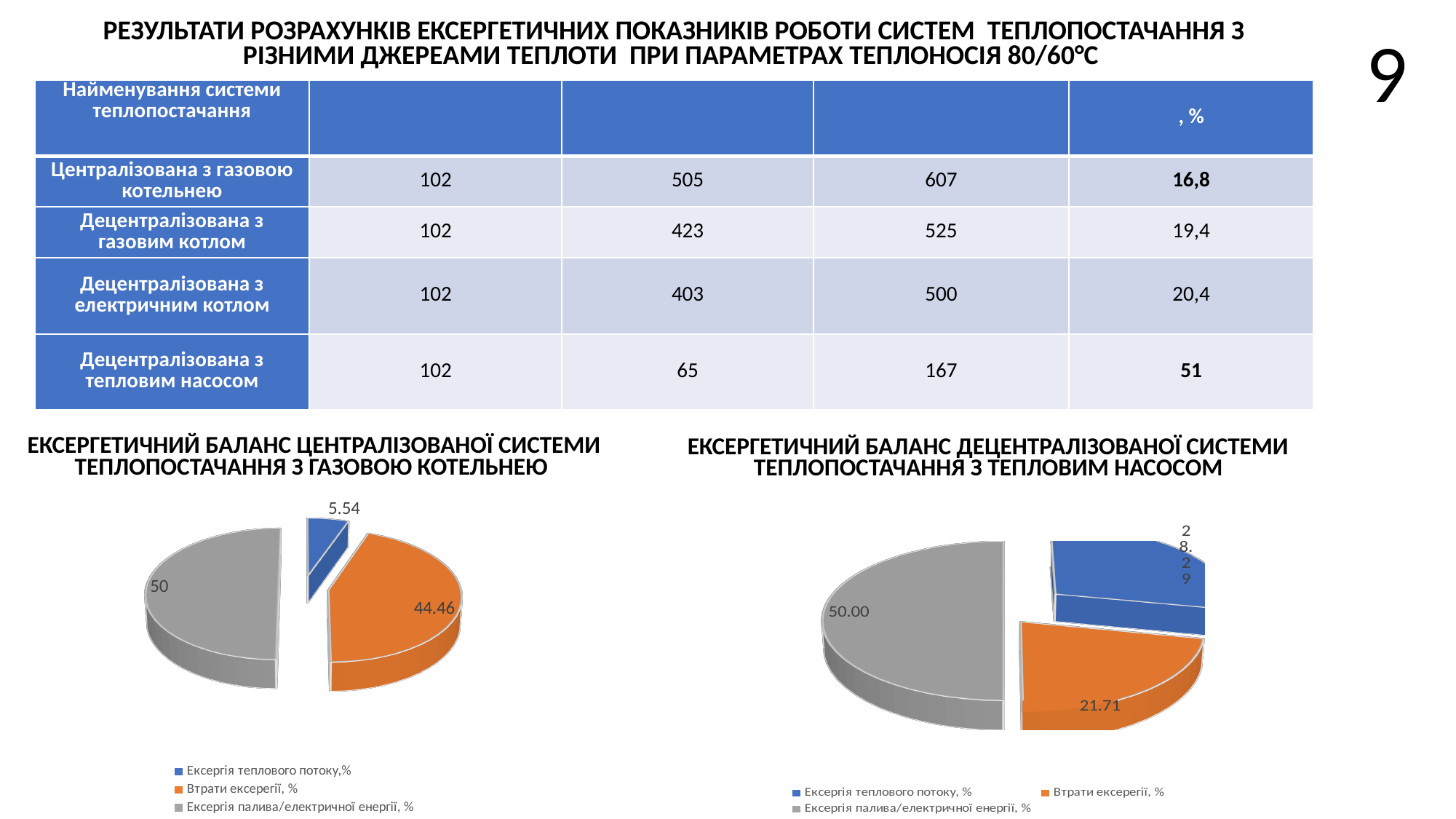
In the right pie chart (decentralised system with heat pump), what colour is the slice for Втрати ексерегії, %? Orange In the right pie chart (decentralised system with heat pump), what is the value for Ексергія палива/електричної енергії, %? 50.00 In the left pie chart (centralised system with gas boiler house), what is the value for Втрати ексерегії, %? 44.46 In the left pie chart (centralised system with gas boiler house), what is the difference between the values for Ексергія палива/електричної енергії and Втрати ексерегії? 5.54 In the right pie chart (decentralised system with heat pump), which is larger: Ексергія теплового потоку or Втрати ексерегії? Ексергія теплового потоку, % How many slices does the left pie chart (centralised system with gas boiler house) have? 3 In the right pie chart (decentralised system with heat pump), what is the value for Втрати ексерегії, %? 21.71 What type of chart is used for the exergy balance of the decentralised system with heat pump? Pie chart In the left pie chart (centralised system with gas boiler house), which category has the smallest slice? Ексергія теплового потоку,% In the right pie chart (decentralised system with heat pump), which category has the largest slice? Ексергія палива/електричної енергії, % In the left pie chart (centralised system with gas boiler house), what is the value for Ексергія палива/електричної енергії, %? 50 In the left pie chart (centralised system with gas boiler house), what is the value for Ексергія теплового потоку,%? 5.54